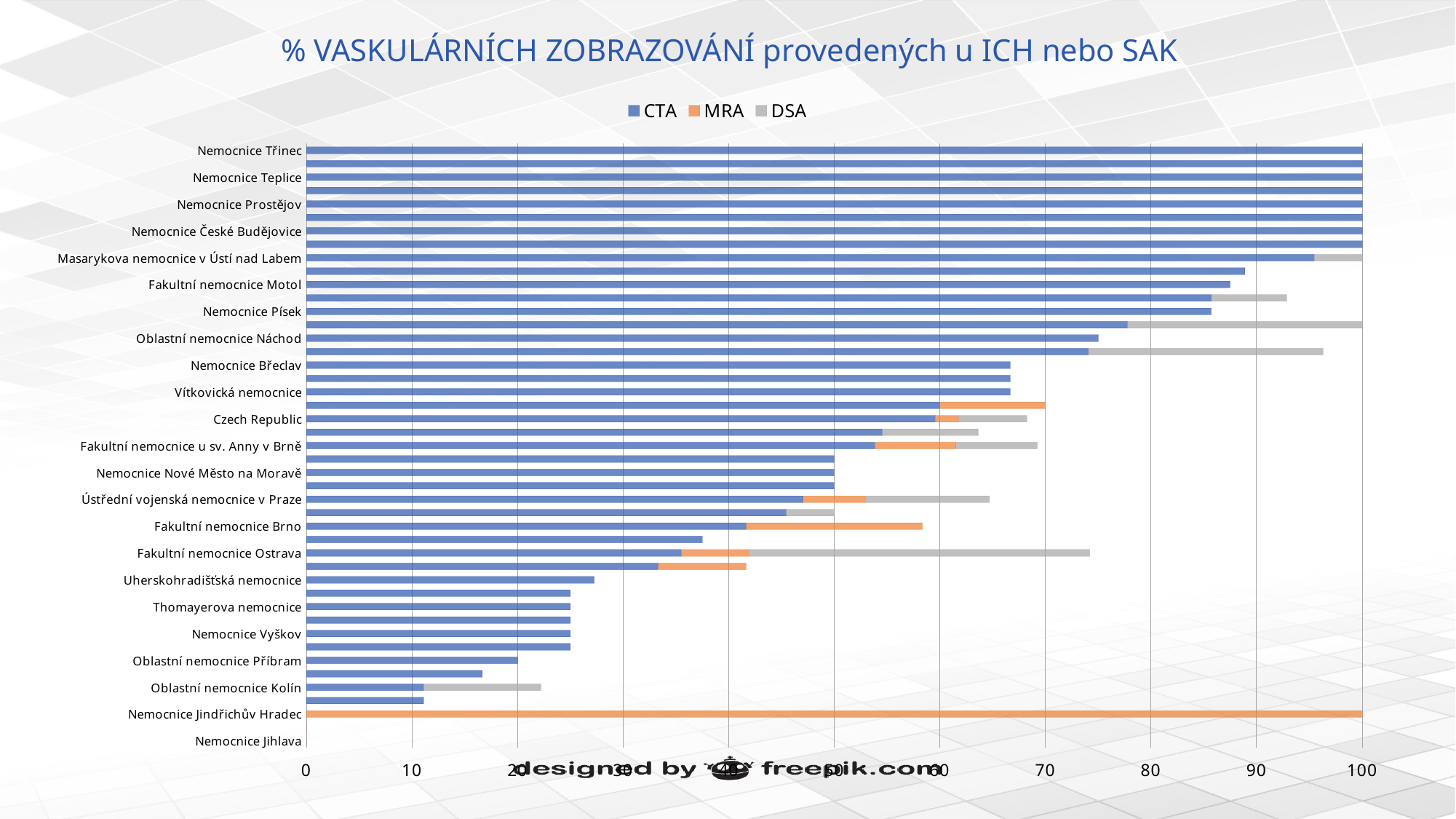
Is the CTA value for Fakultní nemocnice Ostrava greater or less than 40? less How many series does the legend list? 3 Is the CTA value for Nemocnice Vyškov greater or less than 30? less Which has the larger CTA value, Nemocnice Třinec or Oblastní nemocnice Kolín? Nemocnice Třinec What is the title of the chart? % VASKULÁRNÍCH ZOBRAZOVÁNÍ provedených u ICH nebo SAK Is the CTA value for Oblastní nemocnice Kolín greater or less than 20? less What type of chart is shown on the slide? bar chart What is the CTA value for Nemocnice Třinec? 100 What is the MRA value for Nemocnice Jindřichův Hradec? 100 What are the series names listed in the legend? CTA, MRA, DSA